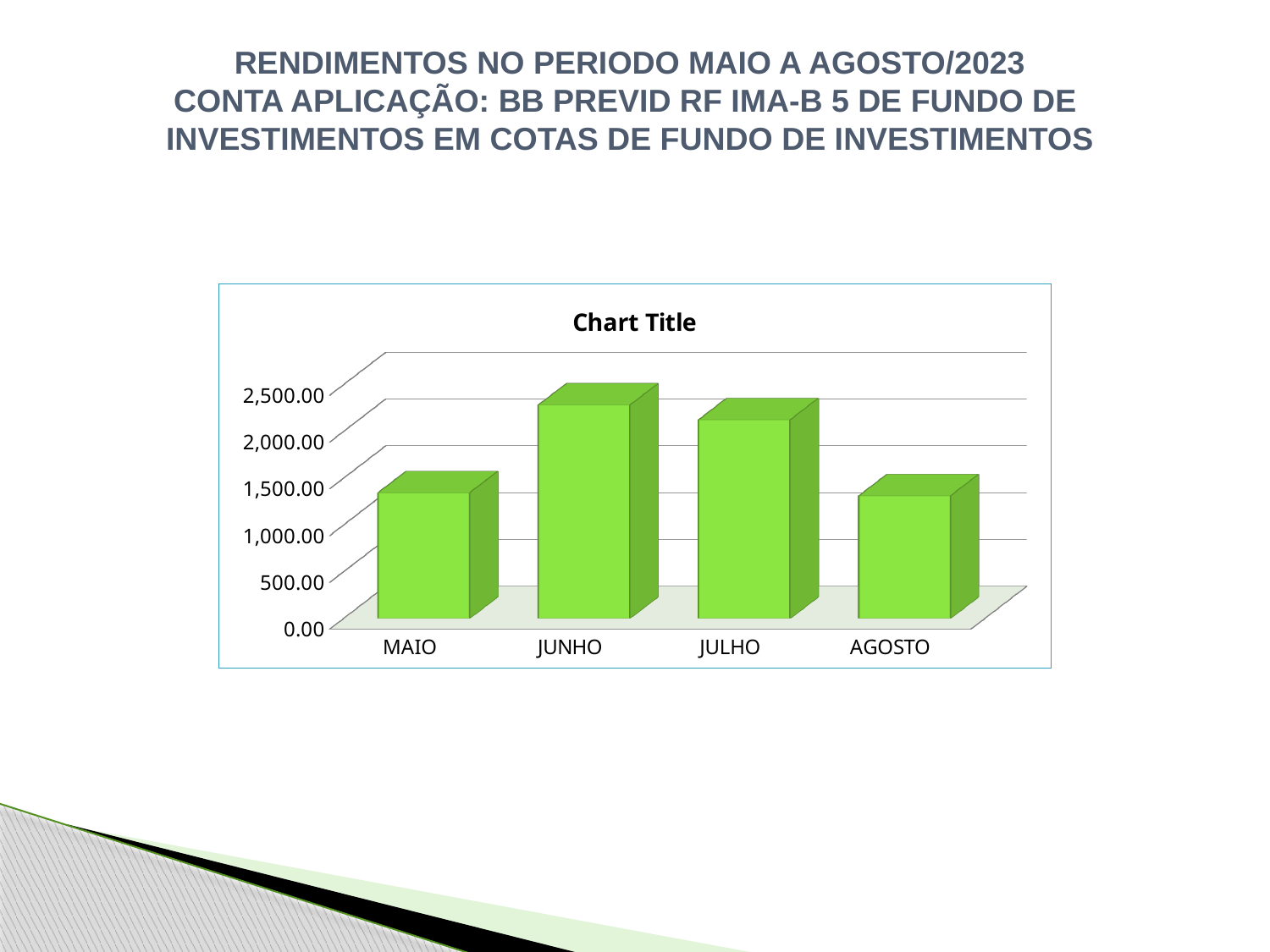
How many categories are shown on the x axis of the chart? 4 Which is larger, the value for JULHO or the value for AGOSTO? JULHO What kind of chart is shown on the slide? bar chart What title is printed above the chart? Chart Title Is the value for AGOSTO greater or less than 1,500.00? less Is the value for JULHO greater or less than 1,500.00? greater Which is larger, the value for MAIO or the value for JUNHO? JUNHO Is the value for JUNHO greater or less than 2,000.00? greater Which month has the highest value in the chart? JUNHO Which is larger, the value for JUNHO or the value for JULHO? JUNHO Do the values rise or fall from JUNHO to AGOSTO? fall